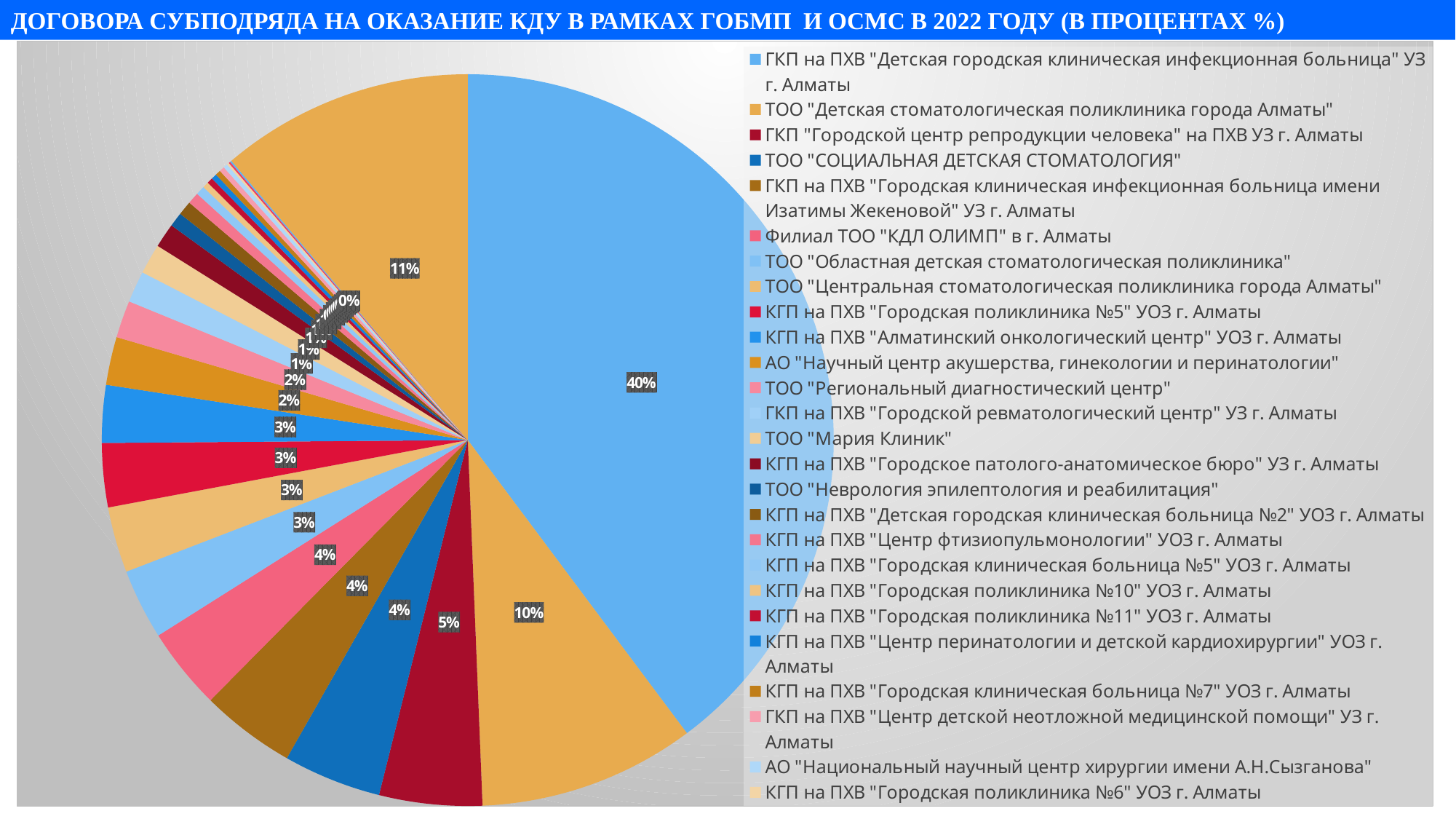
What percentage is shown for ТОО "СОЦИАЛЬНАЯ ДЕТСКАЯ СТОМАТОЛОГИЯ"? 4% What percentage is shown for ГКП "Городской центр репродукции человека" на ПХВ УЗ г. Алматы? 5% Which organisation has the largest slice of the pie? ГКП на ПХВ "Детская городская клиническая инфекционная больница" УЗ г. Алматы What colour is the largest slice of the pie? Light blue What percentage is shown for ГКП на ПХВ "Детская городская клиническая инфекционная больница" УЗ г. Алматы? 40% What is the title of the slide? ДОГОВОРА СУБПОДРЯДА НА ОКАЗАНИЕ КДУ В РАМКАХ ГОБМП И ОСМС В 2022 ГОДУ (В ПРОЦЕНТАХ %) Which has the larger share: ТОО "Детская стоматологическая поликлиника города Алматы" or ГКП "Городской центр репродукции человека" на ПХВ УЗ г. Алматы? ТОО "Детская стоматологическая поликлиника города Алматы" How many organisations are listed in the legend? 26 What is the difference in percentage points between the 40% slice and the 10% slice? 30 percentage points What percentage is shown for ТОО "Детская стоматологическая поликлиника города Алматы"? 10% What type of chart is shown on the slide? Pie chart